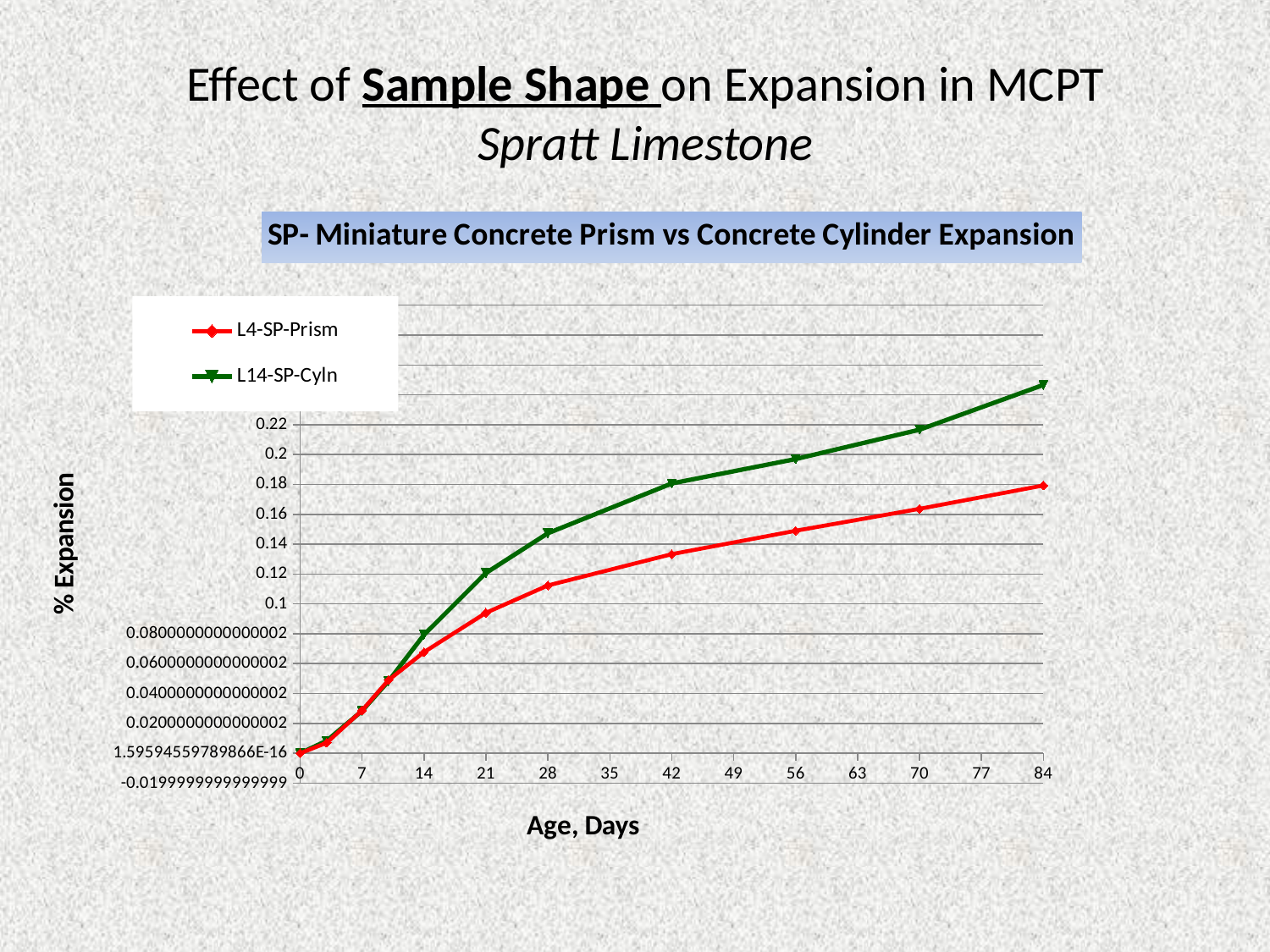
Is the value for L4-SP-Prism at 56 days greater or less than 0.16? less Is the value for L4-SP-Prism at 28 days greater or less than 0.1? greater What is the label of the x axis? Age, Days Which series has the higher value at 84 days, L4-SP-Prism or L14-SP-Cyln? L14-SP-Cyln Is the value for L14-SP-Cyln at 84 days greater or less than 0.22? greater What kind of chart is shown on the slide? line chart Do the values for L14-SP-Cyln rise or fall as age increases along the x axis? rise What is the title of the chart? SP- Miniature Concrete Prism vs Concrete Cylinder Expansion How many tick labels are shown on the x axis? 13 How many series does the legend list? 2